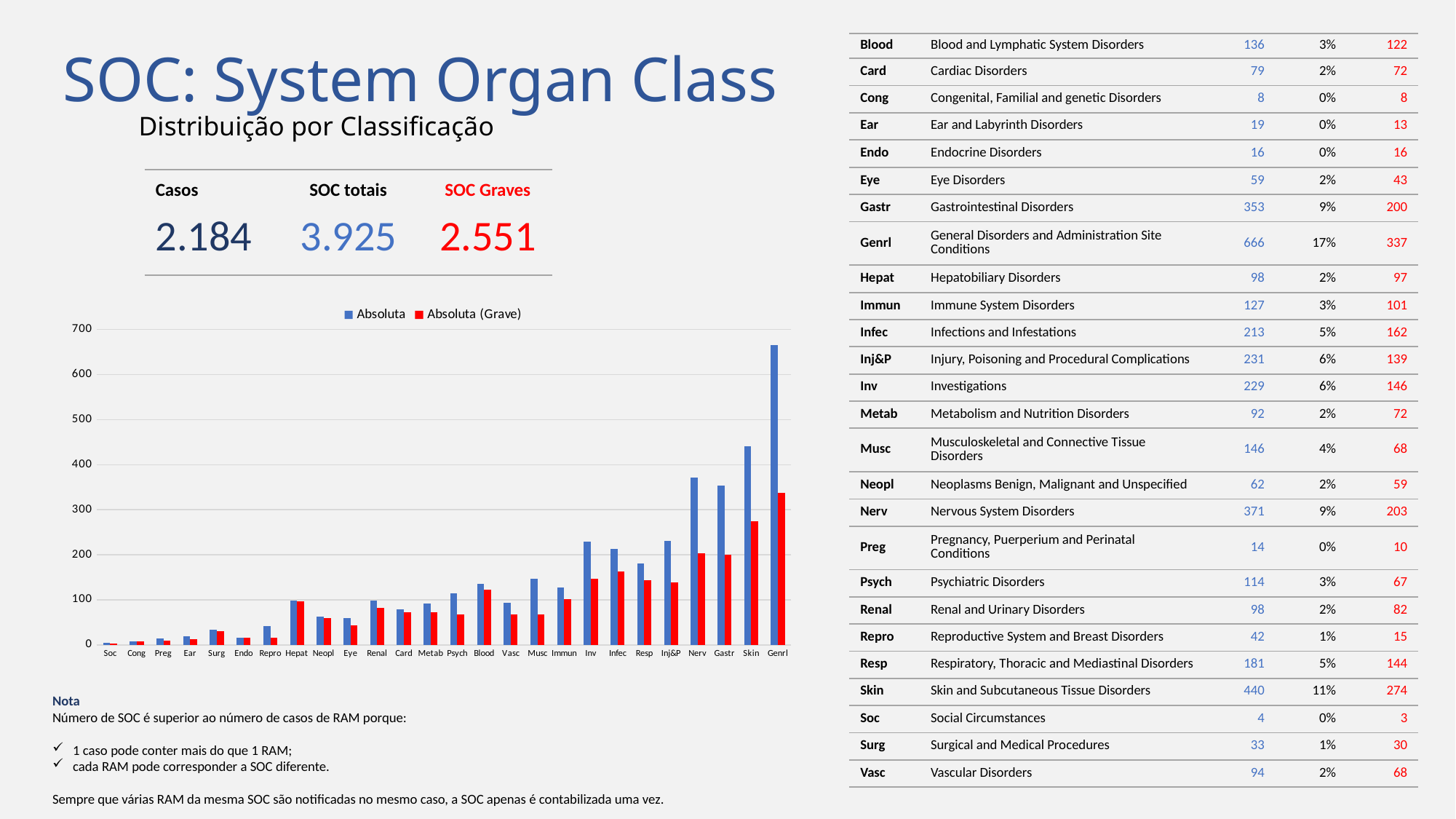
What are the two series named in the chart legend? Absoluta and Absoluta (Grave) Which category has the highest Absoluta value in the chart? Genrl What type of chart is shown on the slide? bar chart Is the Absoluta (Grave) value for Genrl greater or less than 300? greater Do the Absoluta values generally rise or fall from left to right along the x axis? rise How many SOC categories are plotted along the x axis of the chart? 26 Is the Absoluta value for Nerv greater or less than 400? less How many series does the chart legend list? 2 Is the Absoluta (Grave) value for Skin greater or less than 300? less Which colour represents the Absoluta (Grave) series in the chart? red Which has the larger Absoluta value, Inj&P or Resp? Inj&P